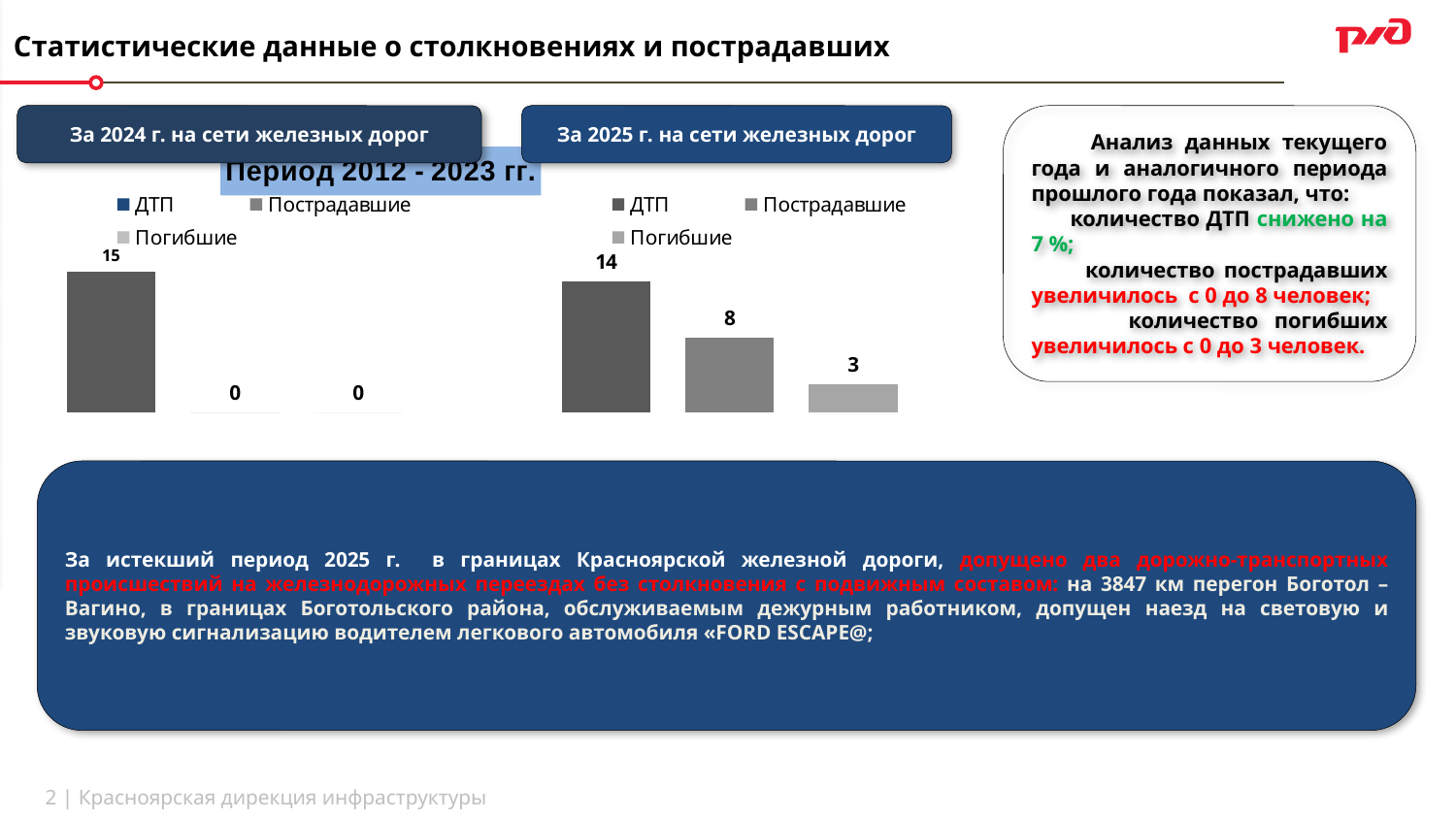
In the chart 'За 2025 г. на сети железных дорог', which series has the highest value? ДТП What kind of chart is 'За 2024 г. на сети железных дорог'? Bar chart In the chart 'За 2025 г. на сети железных дорог', what is the value for ДТП? 14 In the chart 'За 2025 г. на сети железных дорог', what is the difference between ДТП and Пострадавшие? 6 In the chart 'За 2024 г. на сети железных дорог', what is the value for Пострадавшие? 0 In the chart 'За 2025 г. на сети железных дорог', what is the value for Погибшие? 3 In the chart 'За 2025 г. на сети железных дорог', what is the value for Пострадавшие? 8 How many series does the legend of the chart 'За 2025 г. на сети железных дорог' list? 3 In the chart 'За 2024 г. на сети железных дорог', what is the value for ДТП? 15 What are the legend entries of the chart 'За 2024 г. на сети железных дорог'? ДТП, Пострадавшие, Погибшие Which is larger: ДТП in the chart 'За 2024 г. на сети железных дорог' or ДТП in the chart 'За 2025 г. на сети железных дорог'? 2024 (15) In the chart 'За 2025 г. на сети железных дорог', which series has the lowest value? Погибшие